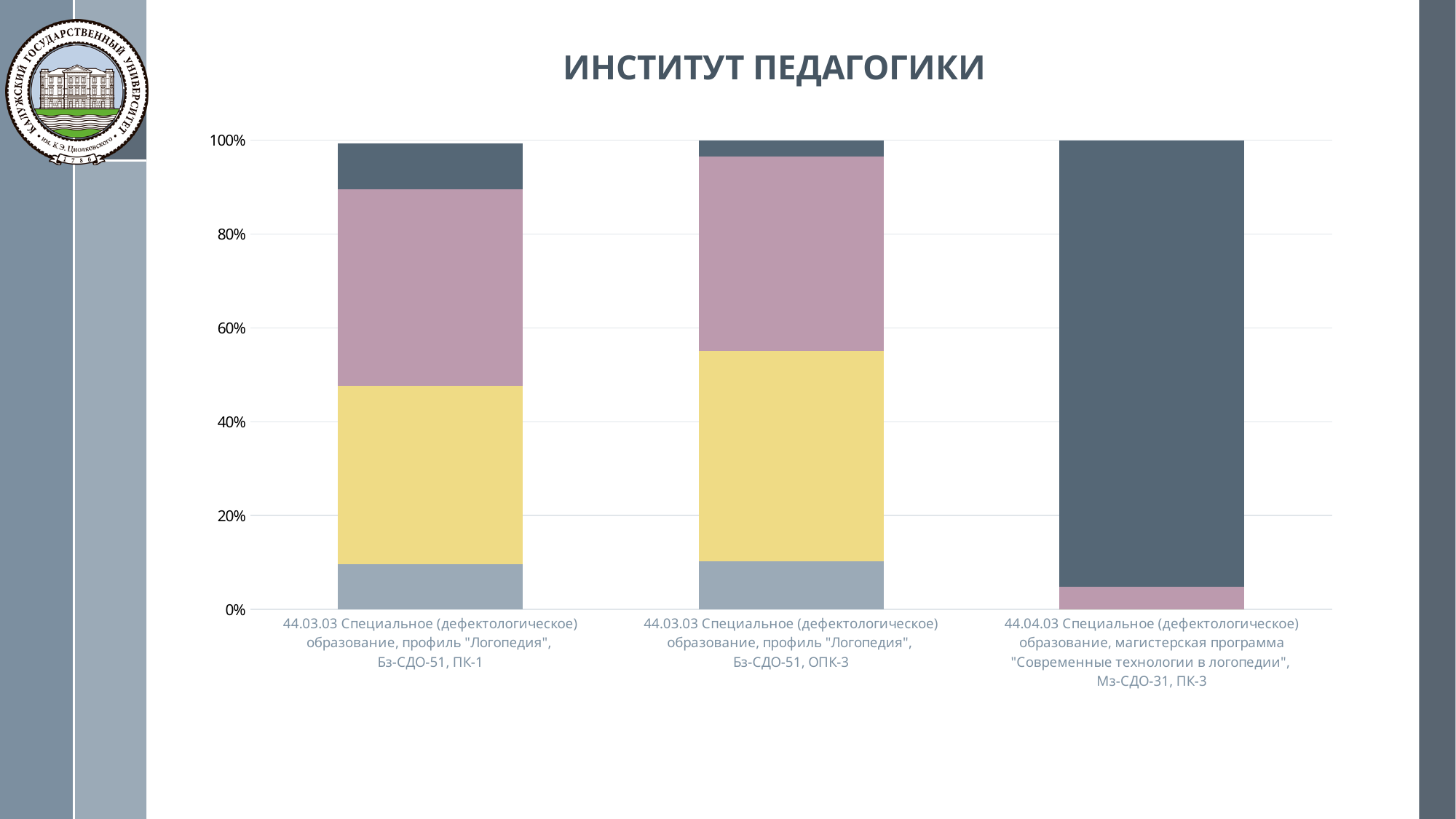
Which bar has the larger pink segment: Бз-СДО-51, ПК-1 or Мз-СДО-31, ПК-3? Бз-СДО-51, ПК-1 Is the top of the yellow segment in the bar for Бз-СДО-51, ПК-1 greater or less than 60%? less Which bar has the largest dark grey segment? 44.04.03 Специальное (дефектологическое) образование, магистерская программа "Современные технологии в логопедии", Мз-СДО-31, ПК-3 Which bar has the larger dark grey segment: Бз-СДО-51, ОПК-3 or Мз-СДО-31, ПК-3? Мз-СДО-31, ПК-3 Which bar has the smallest pink segment? 44.04.03 Специальное (дефектологическое) образование, магистерская программа "Современные технологии в логопедии", Мз-СДО-31, ПК-3 What kind of chart is shown on the slide? stacked bar chart Is the top of the yellow segment in the bar for Бз-СДО-51, ОПК-3 greater or less than 50%? greater Is the top of the pink segment in the bar for Мз-СДО-31, ПК-3 greater or less than 20%? less What is the title of the slide above the chart? ИНСТИТУТ ПЕДАГОГИКИ How many categories (bars) are plotted on the chart? 3 What is the highest value shown on the vertical axis of the chart? 100%